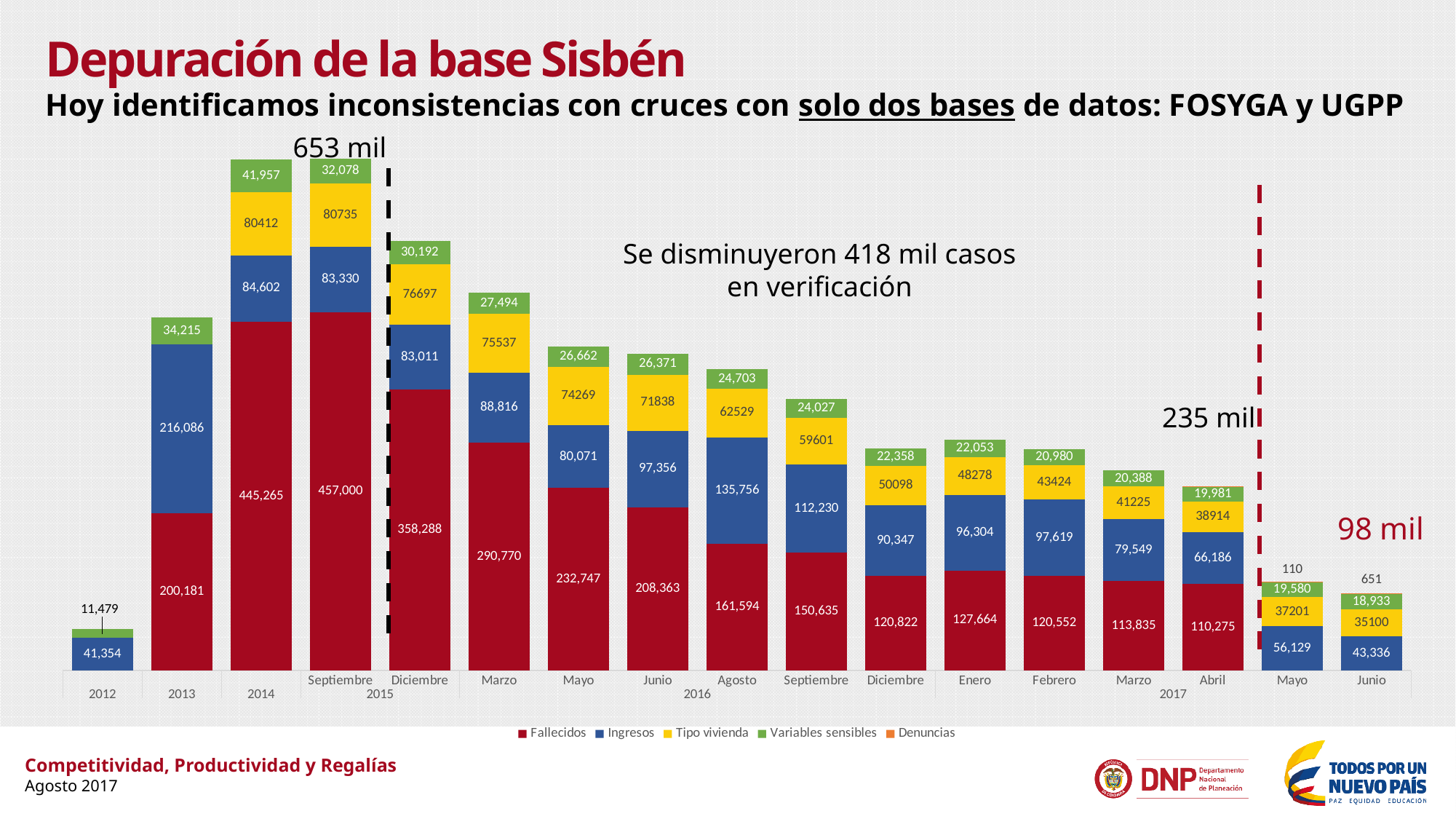
What is the total of the stacked bar for Junio 2017? 98,020 What is the Ingresos value for Agosto 2016? 135,756 How many series does the legend list? 5 What is the Tipo vivienda value for Marzo 2017? 41225 What kind of chart is shown on the slide? Stacked bar chart What is the Fallecidos value for Septiembre 2015? 457,000 What is the difference between the Fallecidos value for Diciembre 2015 and for Marzo 2016? 67,518 In 2013, which is larger: the Ingresos value or the Fallecidos value? Ingresos What is the Denuncias value for Mayo 2017? 110 Do the Fallecidos values rise or fall from Septiembre 2015 to Abril 2017? Fall Which period has the highest Fallecidos value? Septiembre 2015 How many bars (periods) are shown on the x axis? 17